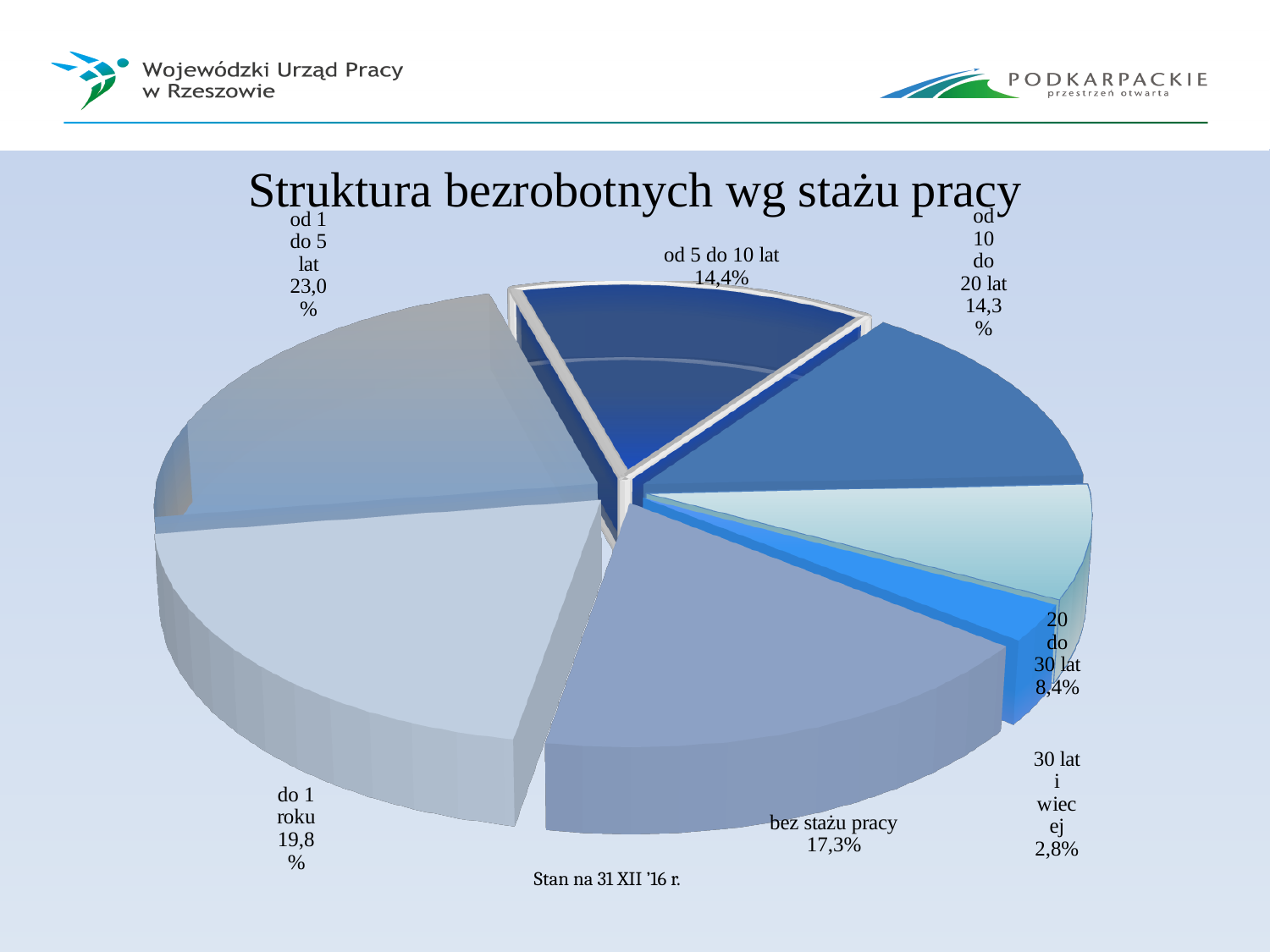
What is the value shown for '20 do 30 lat'? 8,4% What kind of chart is shown on the slide? pie chart What is the value shown for 'do 1 roku'? 19,8% What is the difference between the values for 'od 1 do 5 lat' and 'do 1 roku'? 3,2 percentage points Which is larger: the slice for 'bez stażu pracy' or the slice for 'od 5 do 10 lat'? bez stażu pracy Which category has the largest slice of the pie? od 1 do 5 lat What is the title of the chart? Struktura bezrobotnych wg stażu pracy How many categories (slices) does the pie chart have? 7 Which category has the smallest slice of the pie? 30 lat i więcej What share of the pie does the slice 'od 1 do 5 lat' represent? 23,0% What is the value shown for 'bez stażu pracy'? 17,3% What date is given below the chart as the reference date ('Stan na')? 31 XII '16 r.